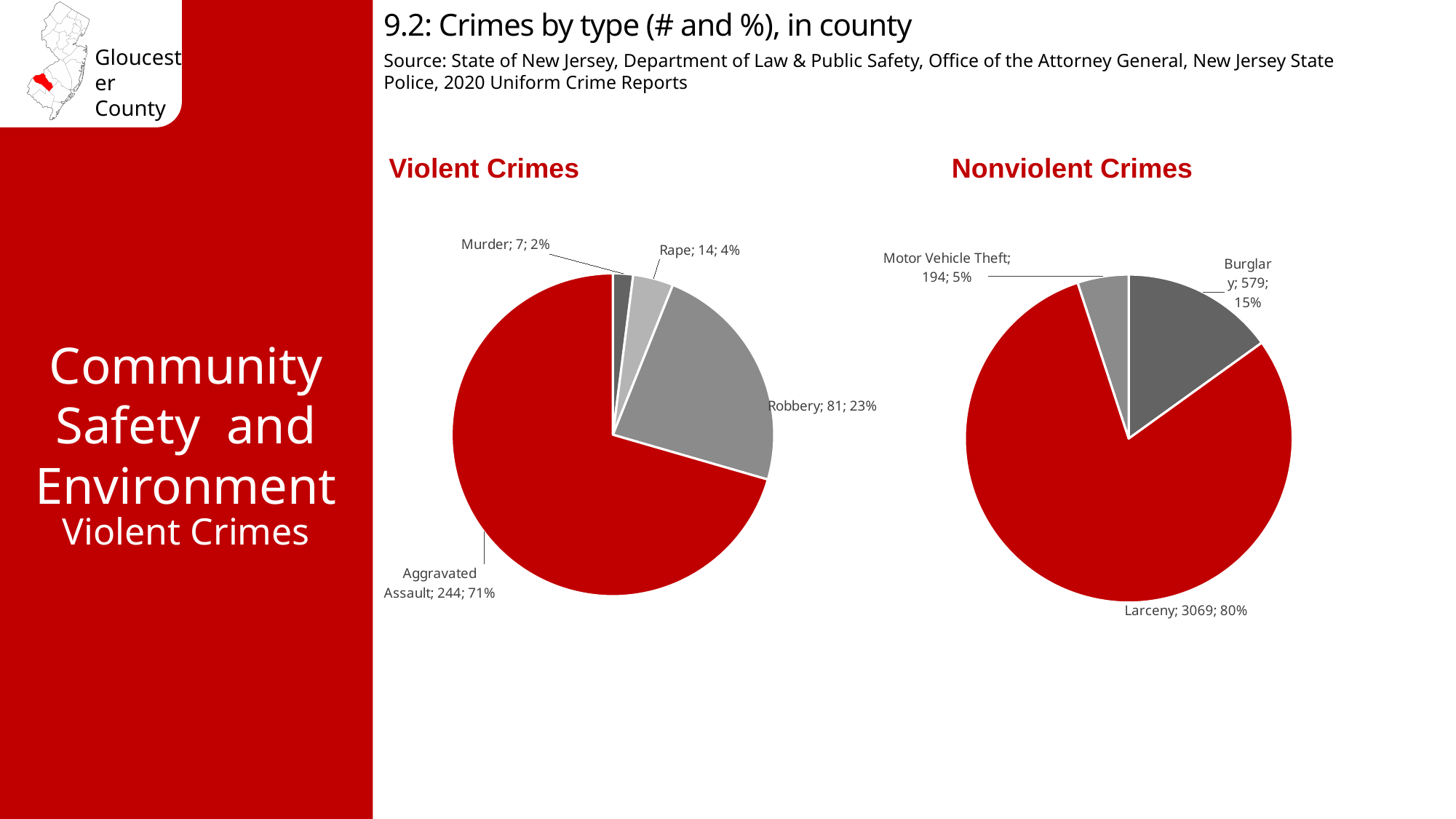
In the Violent Crimes pie chart, how many aggravated assaults are shown? 244 In the Violent Crimes pie chart, what percentage share does Robbery have? 23% In the Violent Crimes pie chart, what is the difference between the number of robberies and the number of rapes? 67 In the Violent Crimes pie chart, which category has the largest slice? Aggravated Assault In the Nonviolent Crimes pie chart, which category has the smallest slice? Motor Vehicle Theft In the Nonviolent Crimes pie chart, what is the difference between the number of burglaries and the number of motor vehicle thefts? 385 What type of chart is used for the Violent Crimes chart? Pie chart In the Nonviolent Crimes pie chart, what percentage share does Burglary have? 15% In the Nonviolent Crimes pie chart, how many larcenies are shown? 3069 In the Violent Crimes pie chart, how many categories are shown? 4 In the Violent Crimes pie chart, which category has the smallest slice? Murder In the Nonviolent Crimes pie chart, how many categories are shown? 3